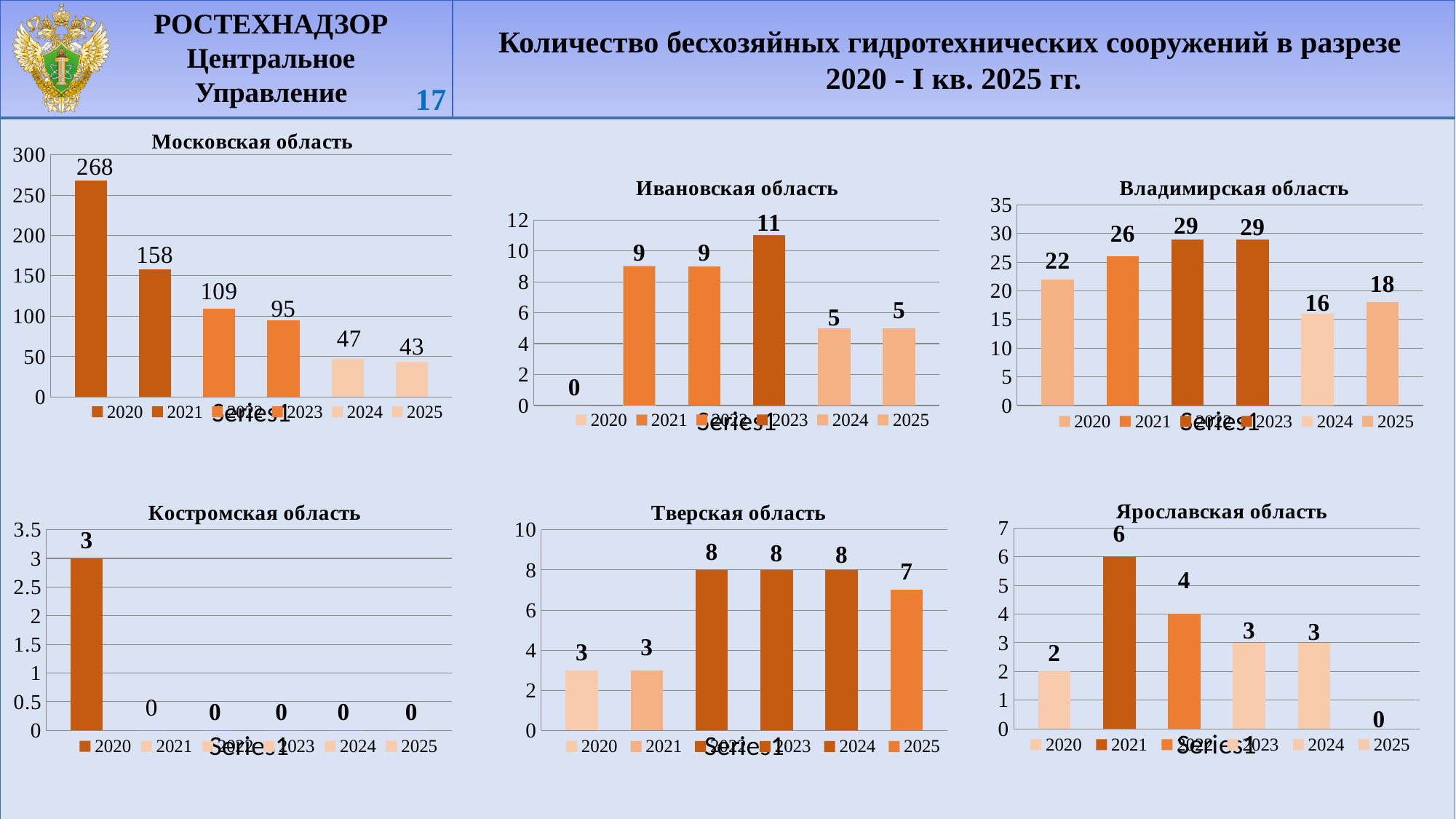
In the 'Ивановская область' chart, which year has the highest value? 2023 In the 'Ивановская область' chart, what is the value for 2020? 0 In the 'Московская область' chart, what is the difference between the values for 2020 and 2021? 110 In the 'Владимирская область' chart, which is larger, the value for 2021 or the value for 2025? 2021 In the 'Московская область' chart, do the values rise or fall from 2020 to 2025? fall What kind of chart is the 'Ярославская область' chart? bar chart In the 'Владимирская область' chart, what is the value for 2024? 16 In the 'Московская область' chart, what is the value for 2020? 268 In the 'Костромская область' chart, which year has the highest value? 2020 In the 'Ярославская область' chart, what is the difference between the values for 2021 and 2022? 2 How many bar charts are shown on the slide? 6 In the 'Тверская область' chart, what is the value for 2025? 7